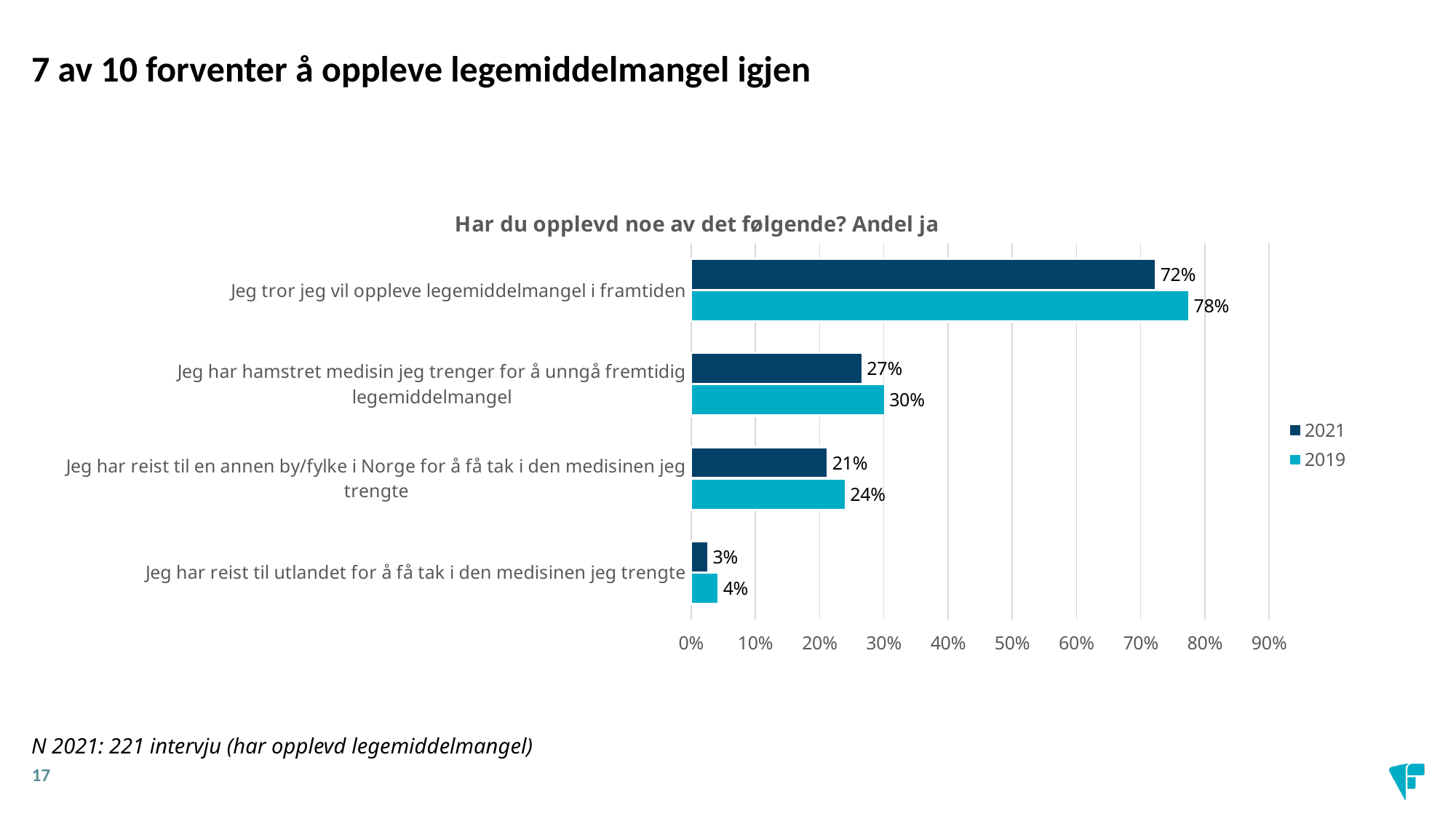
What is the 2021 value for "Jeg har reist til utlandet for å få tak i den medisinen jeg trengte"? 3% What kind of chart is shown on the slide? Bar chart For "Jeg har reist til en annen by/fylke i Norge for å få tak i den medisinen jeg trengte", which year has the larger value, 2021 or 2019? 2019 Which series is shown in dark blue in the legend? 2021 Which category has the lowest 2021 value? Jeg har reist til utlandet for å få tak i den medisinen jeg trengte What is the 2019 value for "Jeg har hamstret medisin jeg trenger for å unngå fremtidig legemiddelmangel"? 30% What is the 2021 value for "Jeg tror jeg vil oppleve legemiddelmangel i framtiden"? 72% How many categories are shown in the chart? 4 Which category has the highest 2019 value? Jeg tror jeg vil oppleve legemiddelmangel i framtiden What is the difference between the 2019 and 2021 values for "Jeg tror jeg vil oppleve legemiddelmangel i framtiden"? 6% What is the title of the chart? Har du opplevd noe av det følgende? Andel ja How many series does the legend list? 2